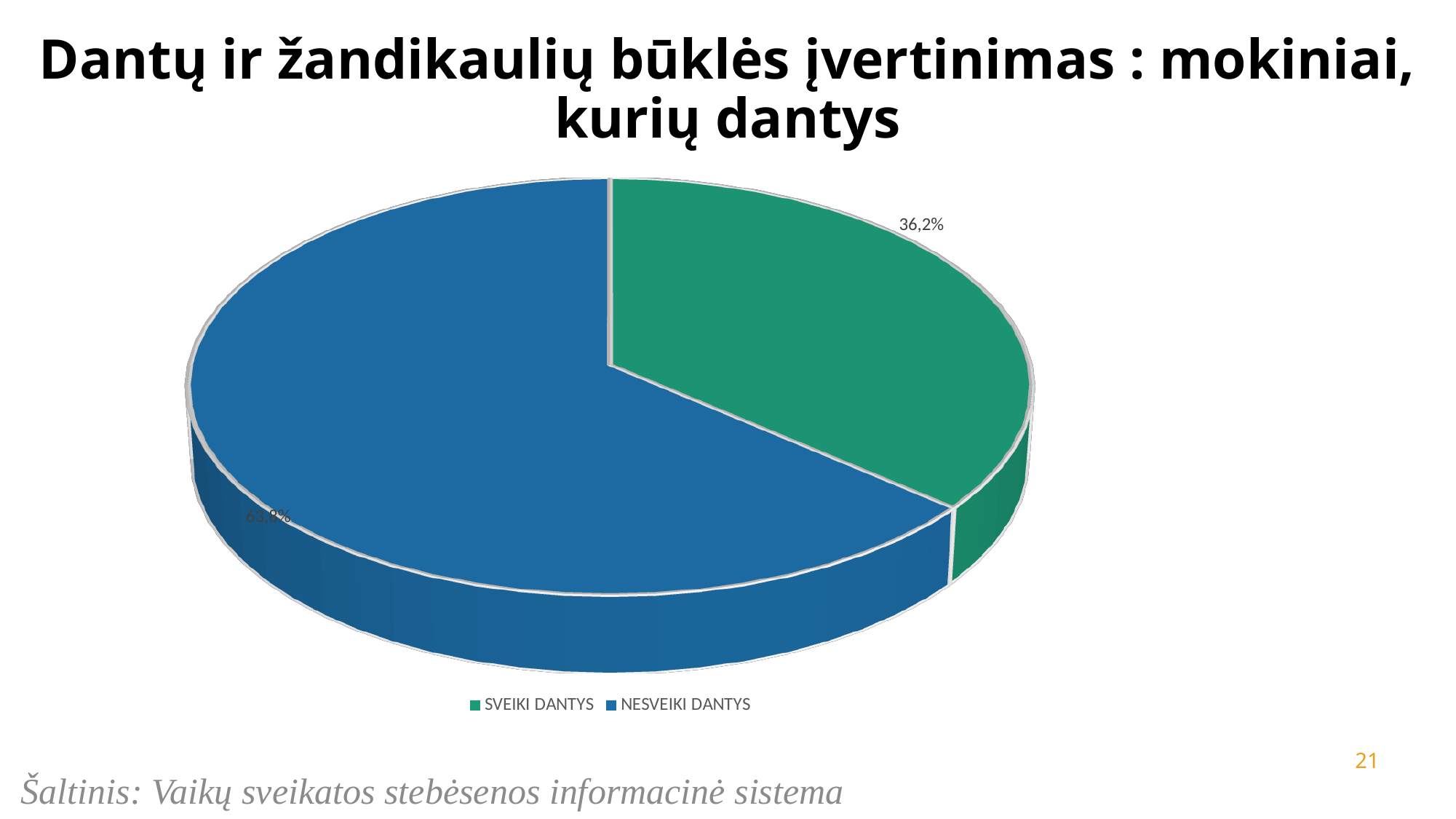
What is the difference in percentage points between NESVEIKI DANTYS and SVEIKI DANTYS? 27,6 What percentage of the pie is labelled SVEIKI DANTYS? 36,2% What colour is the NESVEIKI DANTYS slice? blue What kind of chart is shown on the slide? pie chart Is the share for SVEIKI DANTYS greater or less than 50%? less How many slices does the pie chart have? 2 What percentage of the pie is labelled NESVEIKI DANTYS? 63,8% Which slice is the largest? NESVEIKI DANTYS How many entries does the legend list? 2 What colour is the SVEIKI DANTYS slice? green Which slice is the smallest? SVEIKI DANTYS Which is larger, the SVEIKI DANTYS slice or the NESVEIKI DANTYS slice? NESVEIKI DANTYS